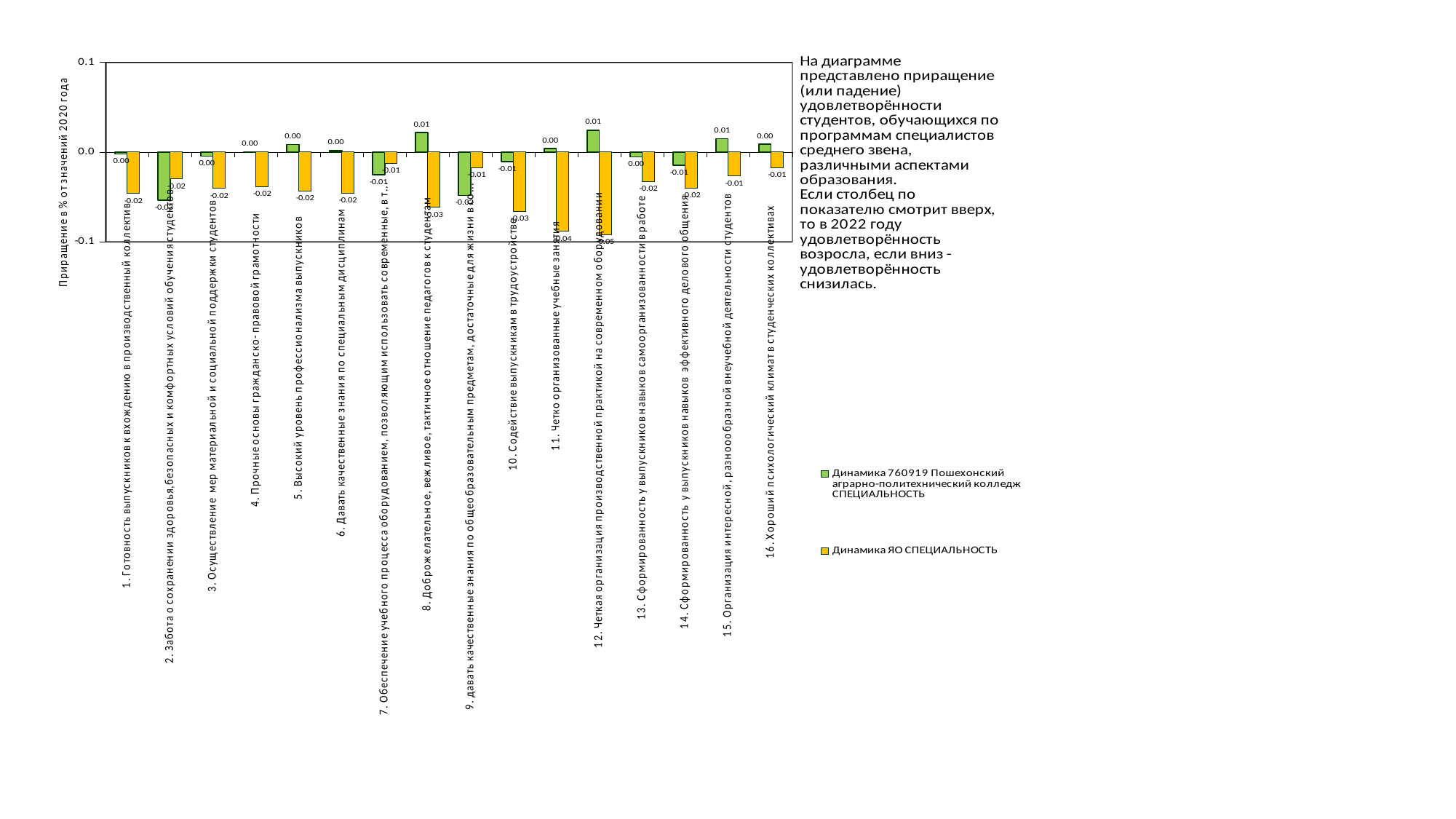
What is the title of the vertical axis? Приращение в % от значений 2020 года Which colour represents the 'Динамика ЯО СПЕЦИАЛЬНОСТЬ' series? Yellow How many categories are plotted along the x axis? 16 Which is larger: the 'Динамика ЯО СПЕЦИАЛЬНОСТЬ' value for category 1 or for category 12? Category 1 What is the difference between the 'Динамика ЯО СПЕЦИАЛЬНОСТЬ' values for category 1 (-0.02) and category 12 (-0.05)? 0.03 For which category is the 'Динамика ЯО СПЕЦИАЛЬНОСТЬ' value the lowest? 12. Четкая организация производственной практикой на современном оборудовании How many series does the legend list? 2 What is the value of the 'Динамика 760919 Пошехонский аграрно-политехнический колледж СПЕЦИАЛЬНОСТЬ' series for category 15 (Организация интересной, разнообразной внеучебной деятельности студентов)? 0.01 What is the value of the 'Динамика ЯО СПЕЦИАЛЬНОСТЬ' series for category 12 (Четкая организация производственной практикой на современном оборудовании)? -0.05 What is the value of the 'Динамика ЯО СПЕЦИАЛЬНОСТЬ' series for category 8 (Доброжелательное, вежливое, тактичное отношение педагогов к студентам)? -0.03 What is the value of the 'Динамика ЯО СПЕЦИАЛЬНОСТЬ' series for category 11 (Четко организованные учебные занятия)? -0.04 What kind of chart is shown on the slide? Bar chart